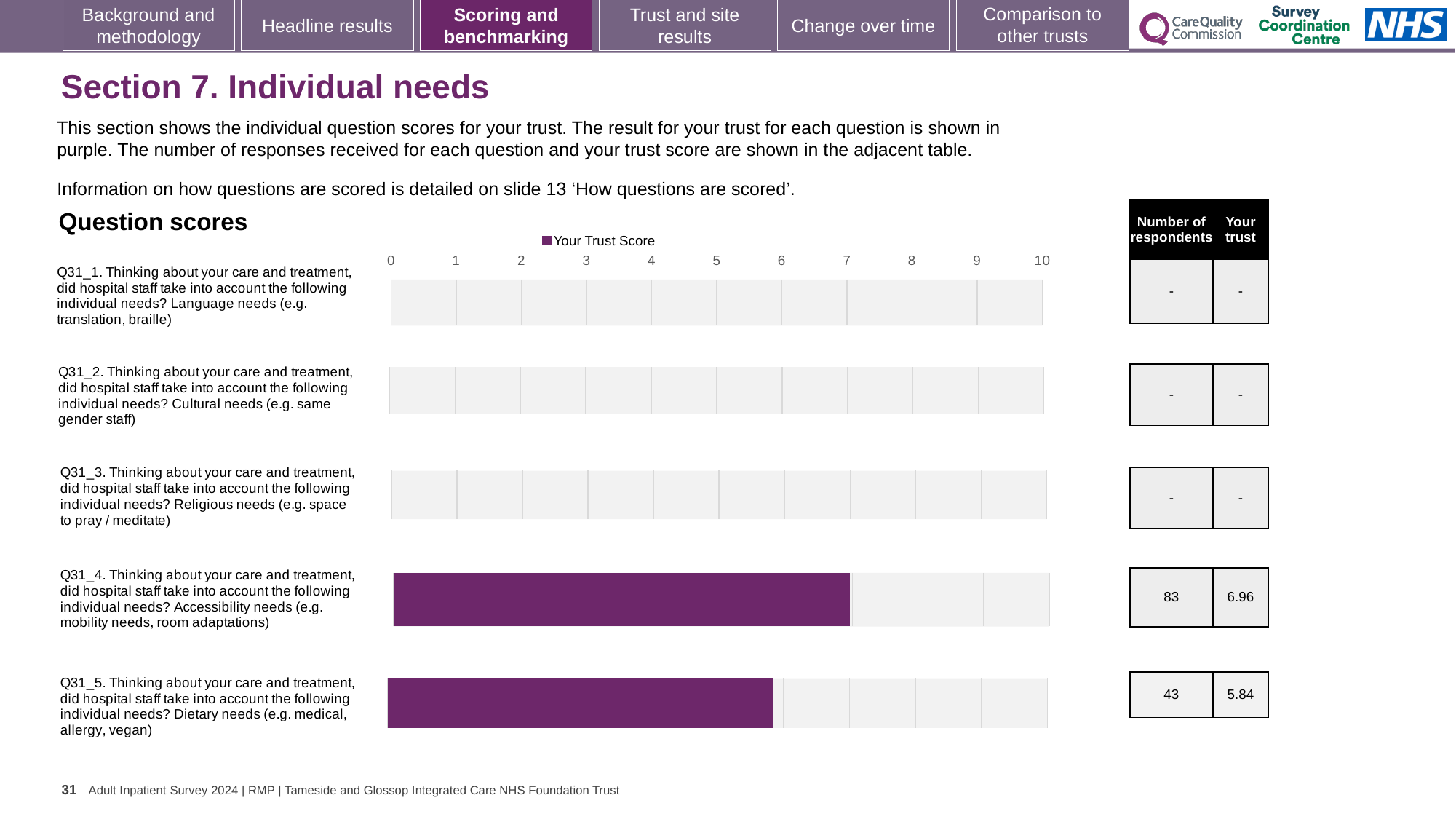
What series does the chart legend list? Your Trust Score What type of chart is used to show the question scores? Bar chart Which has a larger trust score, Q31_4 (Accessibility needs) or Q31_5 (Dietary needs)? Q31_4 (Accessibility needs) What is the trust score for Q31_4 (Accessibility needs)? 6.96 Which question has the highest trust score shown on the chart? Q31_4 (Accessibility needs) Is the trust score for Q31_5 (Dietary needs) greater or less than 6? less What is the difference between the trust scores for Q31_4 and Q31_5? 1.12 How many questions are listed on the chart? 5 How many respondents answered Q31_4 (Accessibility needs)? 83 What is the trust score for Q31_5 (Dietary needs)? 5.84 How many respondents answered Q31_5 (Dietary needs)? 43 Is the trust score for Q31_4 (Accessibility needs) greater or less than 6? greater